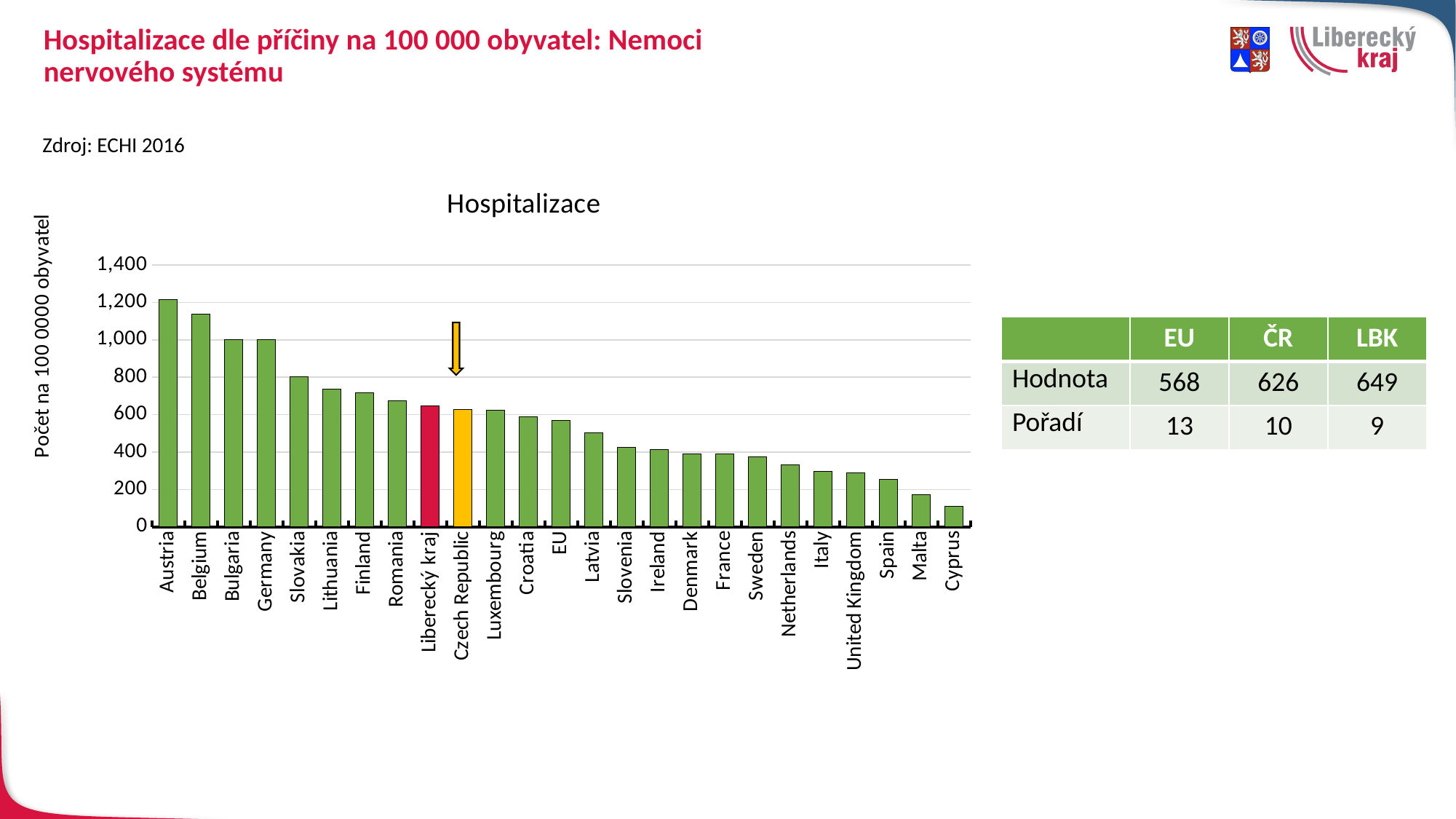
Which has a higher value, Austria or Belgium? Austria Do the values rise or fall from left to right along the x axis? fall Is the value for Latvia greater or less than 400? greater Which country has the highest hospitalisation value in the chart? Austria What is the hospitalisation value for Liberecký kraj (LBK)? 649 What is the difference between the values for LBK and the EU? 81 Is the value for Malta greater or less than 200? less What is the hospitalisation value for the EU? 568 What kind of chart is shown on the slide? bar chart How many bars (categories) are shown in the chart? 25 Which country has the lowest hospitalisation value in the chart? Cyprus What is the hospitalisation value for the Czech Republic (ČR)? 626